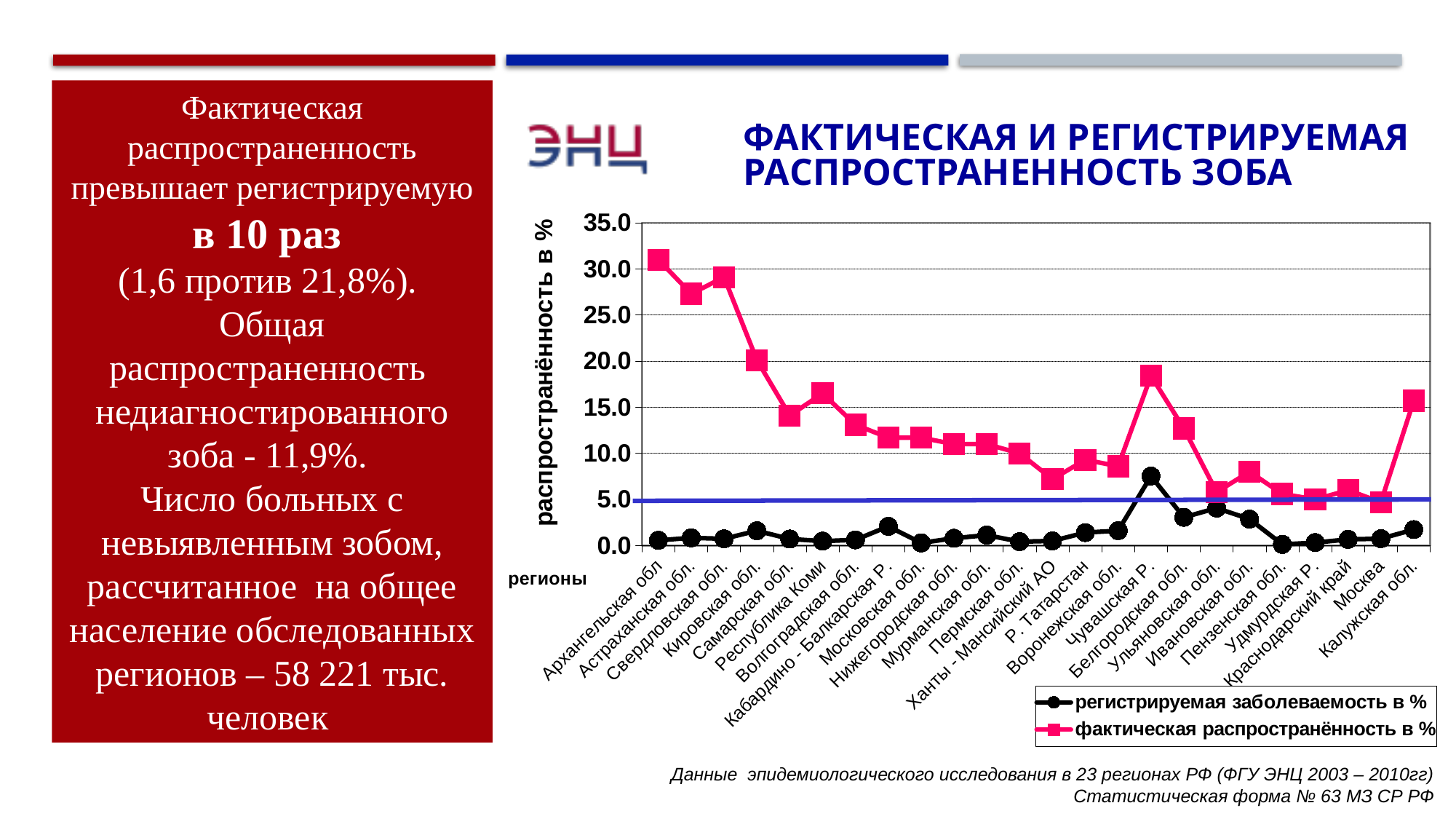
Which region has the highest value for регистрируемая заболеваемость в %? Чувашская Р. How many regions are plotted along the x axis? 24 How many series does the legend list? 2 Is the фактическая распространённость value for Архангельская обл. greater or less than 25.0? greater Is the регистрируемая заболеваемость value for Чувашская Р. greater or less than 5.0? greater Does the фактическая распространённость series generally rise or fall from Архангельская обл. to Ханты-Мансийский АО? fall Which has the larger фактическая распространённость value, Чувашская Р. or Белгородская обл.? Чувашская Р. Is the фактическая распространённость value for Чувашская Р. greater or less than 15.0? greater What colour is the line for фактическая распространённость в % in the legend? pink What kind of chart is shown on the slide? line chart Which region has the highest value for фактическая распространённость в %? Архангельская обл.